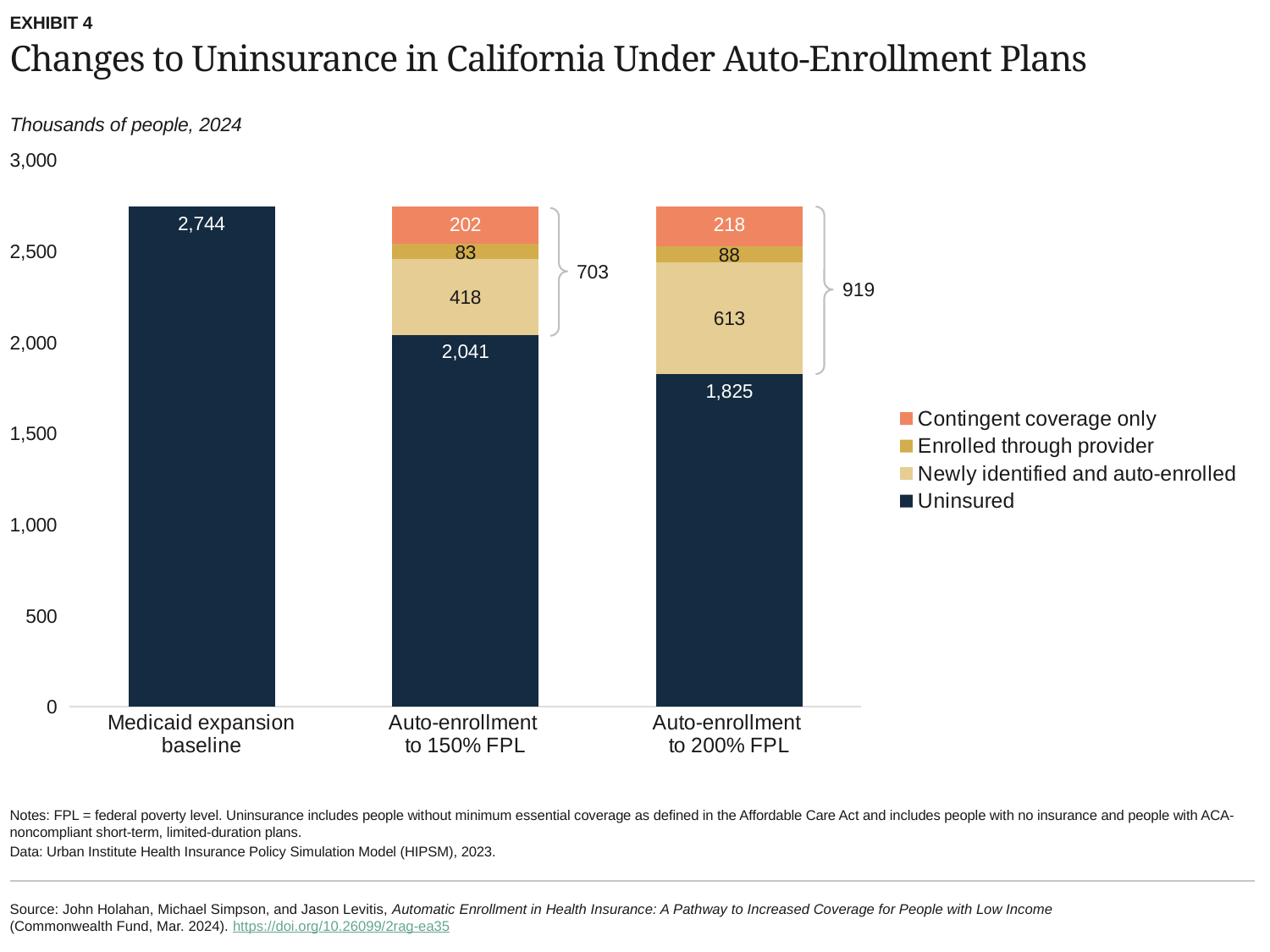
Which scenario has the lowest Uninsured value? Auto-enrollment to 200% FPL How many scenarios (bars) are shown on the x axis? 3 What is the Uninsured value for the Auto-enrollment to 150% FPL bar? 2,041 What is the Contingent coverage only value for the Auto-enrollment to 150% FPL bar? 202 What is the Newly identified and auto-enrolled value for the Auto-enrollment to 200% FPL bar? 613 Which has the larger Enrolled through provider value: Auto-enrollment to 150% FPL or Auto-enrollment to 200% FPL? Auto-enrollment to 200% FPL What is the total of the stacked bar for Auto-enrollment to 150% FPL? 2,744 What kind of chart is shown? Stacked bar chart How many series does the legend list? 4 What is the difference between the Uninsured value for the Medicaid expansion baseline and the Uninsured value for Auto-enrollment to 200% FPL? 919 What value does the bracket next to the Auto-enrollment to 200% FPL bar show? 919 What is the value shown for the Medicaid expansion baseline bar? 2,744